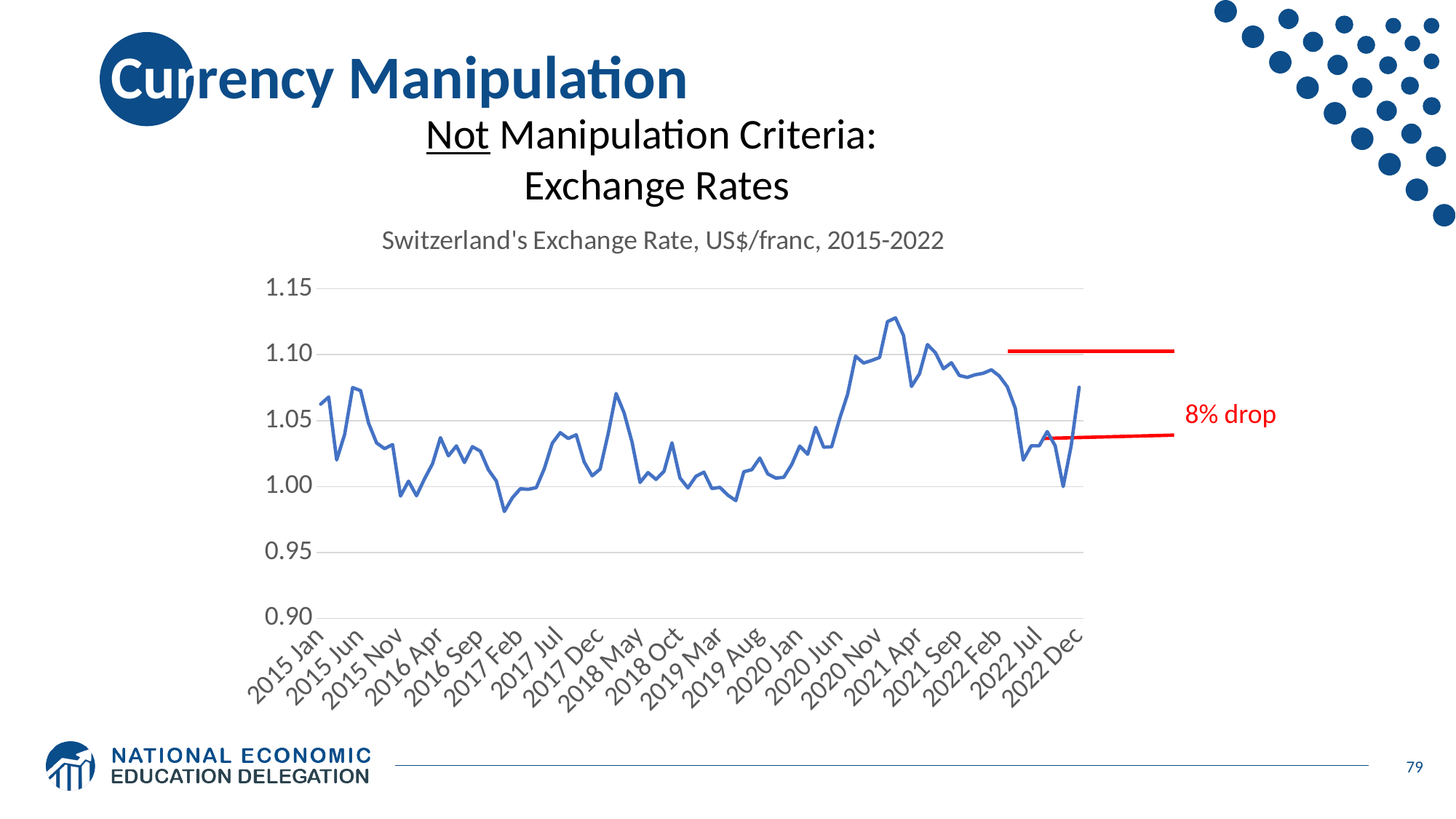
Does the exchange rate rise or fall between 2019 Aug and 2020 Nov? rise Is the highest point on the line greater or less than 1.10? greater Is the value for 2020 Nov greater or less than 1.05? greater What kind of chart is shown on the slide? Line chart Does the exchange rate rise or fall between 2022 Feb and 2022 Jul? fall Is the value for 2015 Jan greater or less than 1.05? greater Which is larger, the value for 2015 Jan or the value for 2017 Feb? 2015 Jan What does the red annotation on the chart say? 8% drop What is the title of the chart? Switzerland's Exchange Rate, US$/franc, 2015-2022